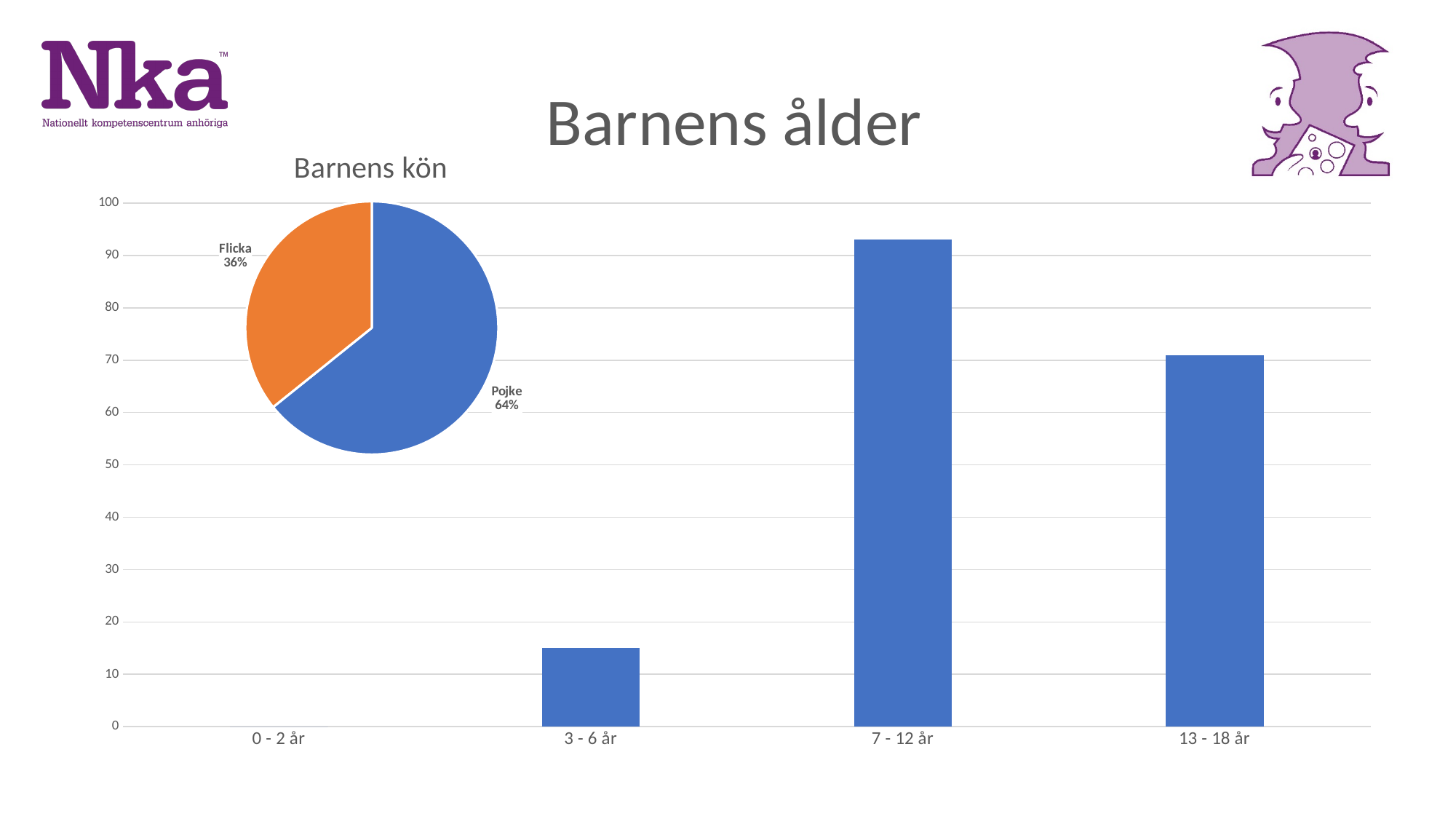
In the 'Barnens kön' pie chart, what share does Pojke have? 64% In the 'Barnens ålder' bar chart, is the value for 3 - 6 år greater or less than 20? less In the 'Barnens ålder' bar chart, which age group has the highest bar? 7 - 12 år In the 'Barnens ålder' bar chart, is the value for 7 - 12 år greater or less than 90? greater What kind of chart is the 'Barnens ålder' chart? bar chart How many age-group categories are shown on the x axis of the 'Barnens ålder' bar chart? 4 What kind of chart is the 'Barnens kön' chart? pie chart How many slices does the 'Barnens kön' pie chart have? 2 In the 'Barnens ålder' bar chart, which is larger: 13 - 18 år or 3 - 6 år? 13 - 18 år In the 'Barnens kön' pie chart, what share does Flicka have? 36% In the 'Barnens kön' pie chart, which slice is the largest? Pojke In the 'Barnens kön' pie chart, how many percentage points larger is Pojke than Flicka? 28